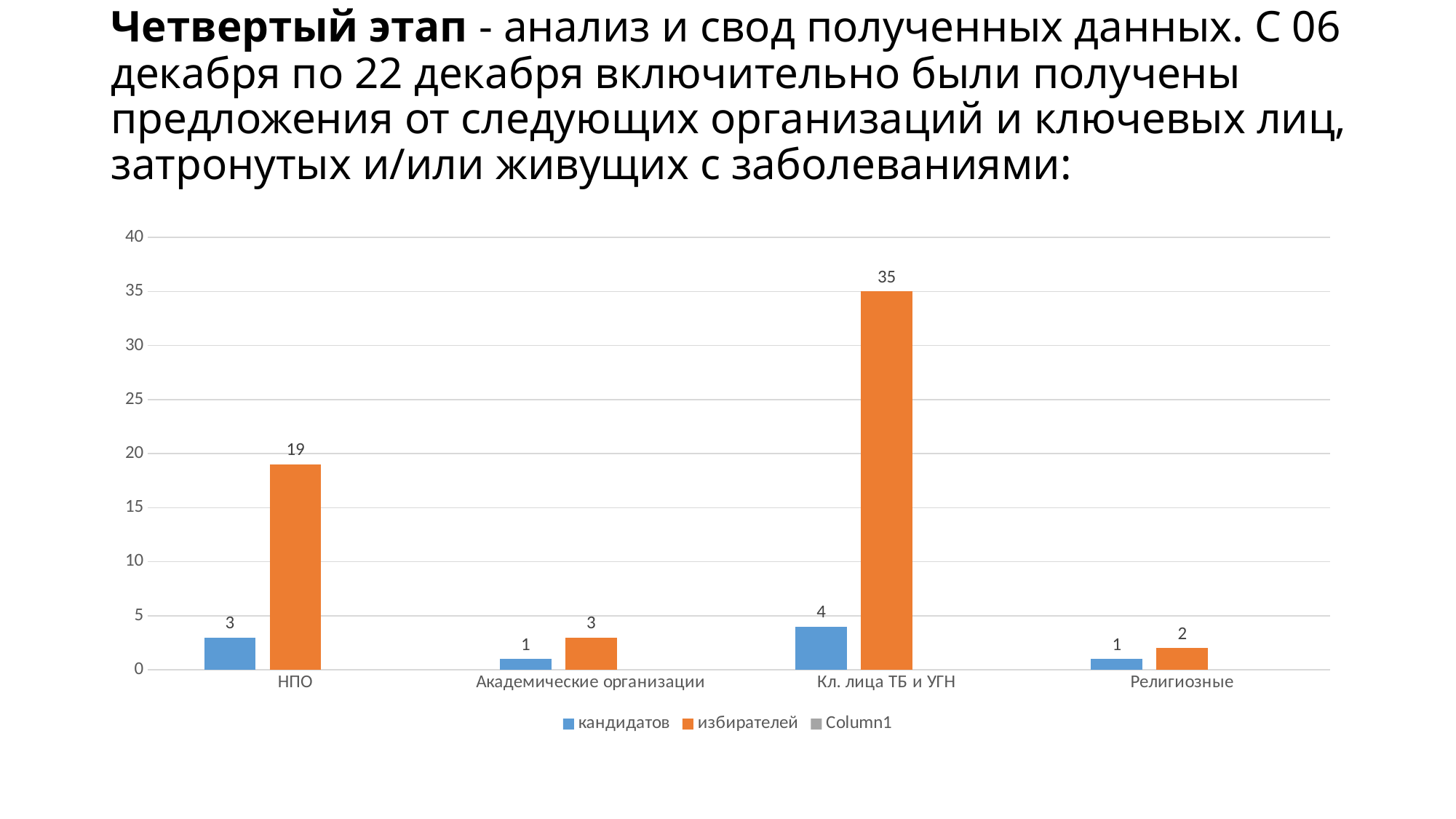
What kind of chart is shown on the slide? bar chart What is the difference between the избирателей values for Кл. лица ТБ и УГН and НПО? 16 What is the value for кандидатов for НПО? 3 Which category has the lowest value for избирателей? Религиозные How many series does the legend list? 3 What is the value for избирателей for Кл. лица ТБ и УГН? 35 What is the value for кандидатов for Академические организации? 1 How many categories are shown on the x axis? 4 Which category has the highest value for избирателей? Кл. лица ТБ и УГН What is the value for избирателей for Религиозные? 2 Which is larger: the кандидатов value for Кл. лица ТБ и УГН or for НПО? Кл. лица ТБ и УГН Is the value for избирателей for НПО greater or less than 15? greater